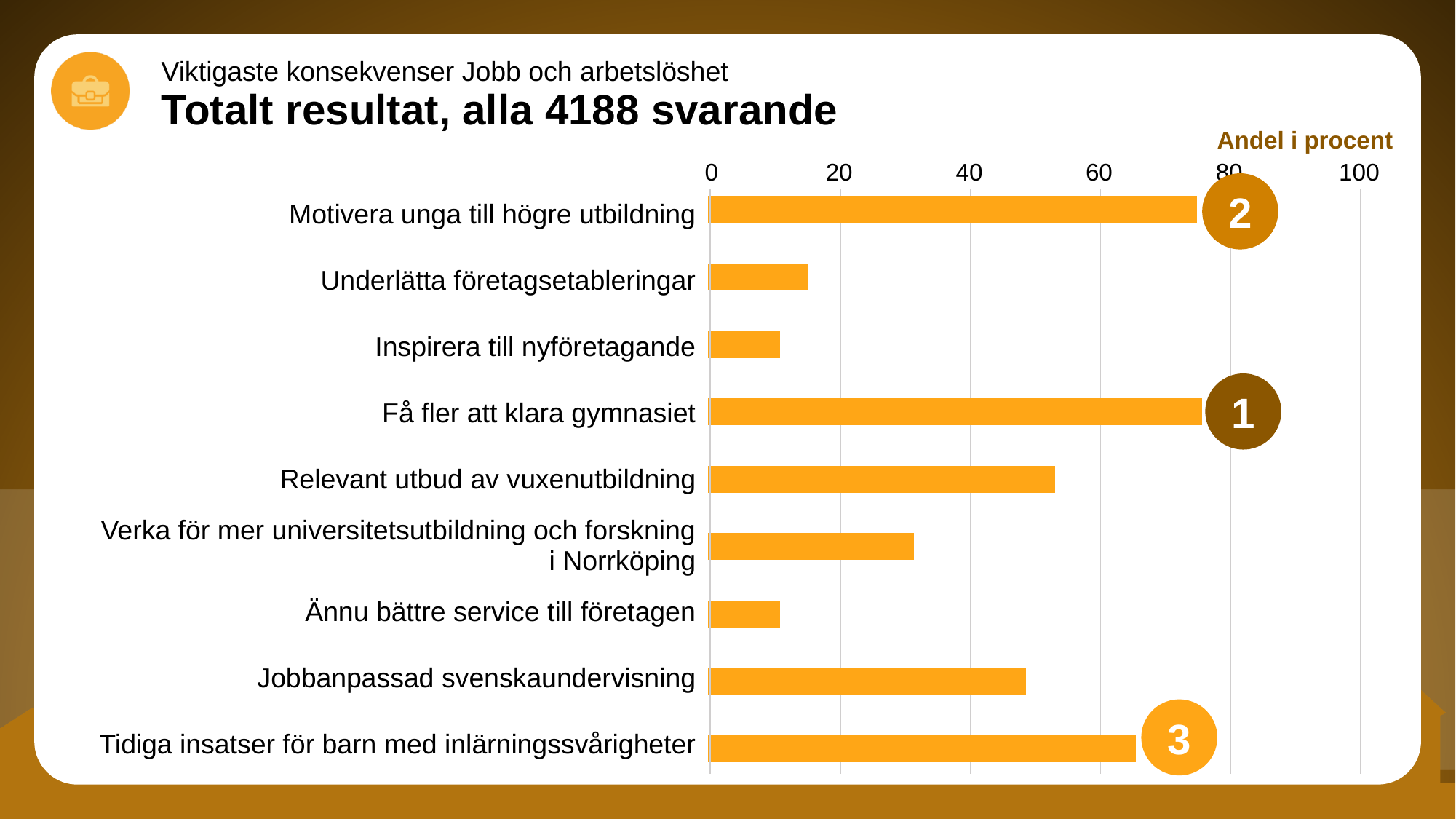
Is the value for Verka för mer universitetsutbildning och forskning i Norrköping greater or less than 40? less Is the value for Ännu bättre service till företagen greater or less than 20? less Is the value for Underlätta företagsetableringar greater or less than 20? less Which category has the highest value in the chart? Få fler att klara gymnasiet What kind of chart is shown on the slide? bar chart Which is larger: the value for Tidiga insatser för barn med inlärningssvårigheter or the value for Relevant utbud av vuxenutbildning? Tidiga insatser för barn med inlärningssvårigheter What label is shown above the horizontal axis of the chart? Andel i procent How many categories are plotted in the chart? 9 Which is larger: the value for Verka för mer universitetsutbildning och forskning i Norrköping or the value for Underlätta företagsetableringar? Verka för mer universitetsutbildning och forskning i Norrköping